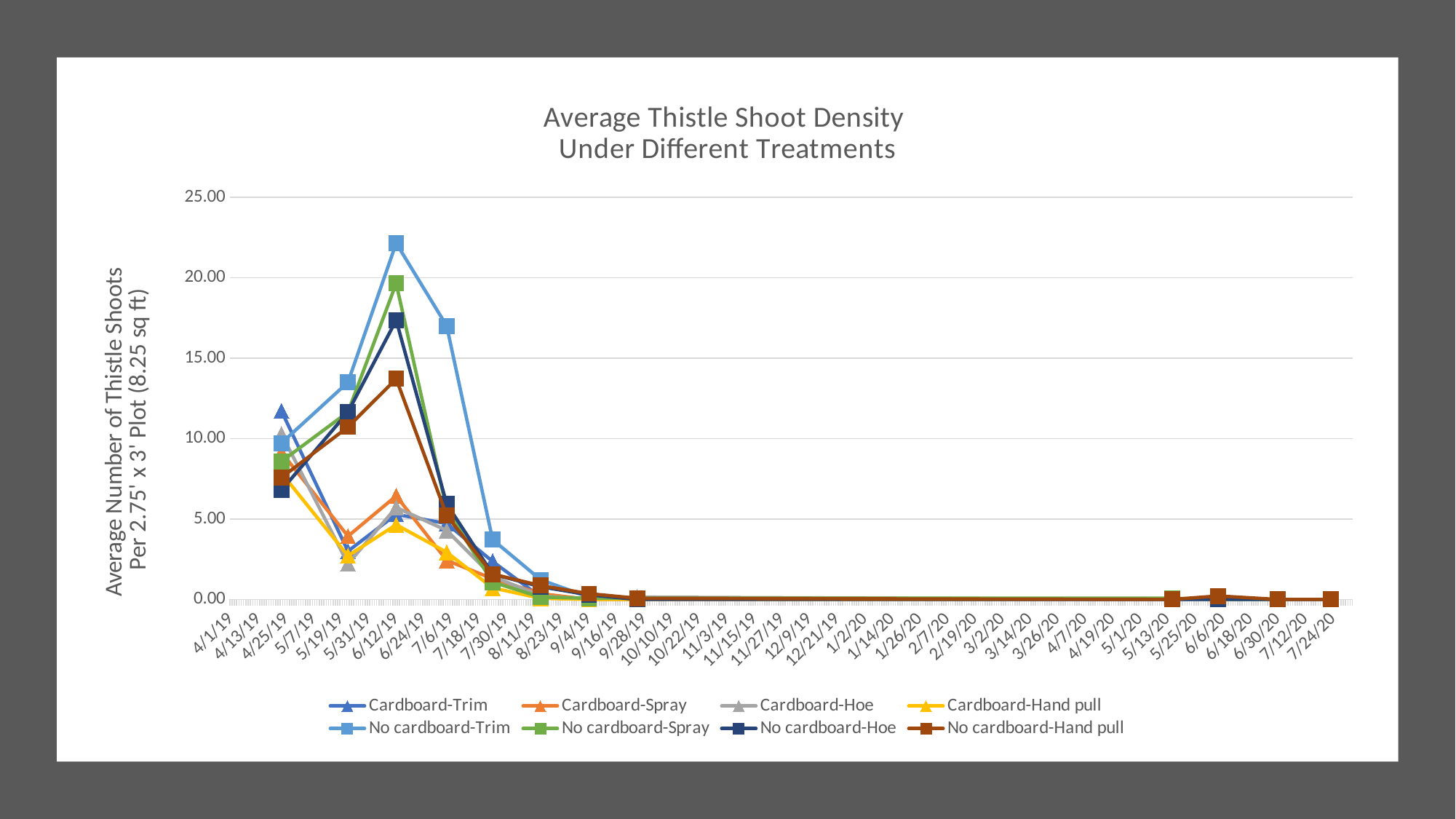
Which series reaches the highest value on the chart? No cardboard-Trim Is the value for No cardboard-Hand pull on 6/12/19 greater or less than 15.00? less What is the highest tick value shown on the y axis? 25.00 Is the value for No cardboard-Spray on 6/12/19 greater or less than 15.00? greater What is the title of the chart? Average Thistle Shoot Density Under Different Treatments Is the value for Cardboard-Spray on 6/12/19 greater or less than 10.00? less Do the values for No cardboard-Trim rise or fall from 6/12/19 to 8/23/19? fall On 6/12/19, which is larger: No cardboard-Trim or Cardboard-Trim? No cardboard-Trim How many series does the legend list? 8 What kind of chart is shown on the slide? line chart